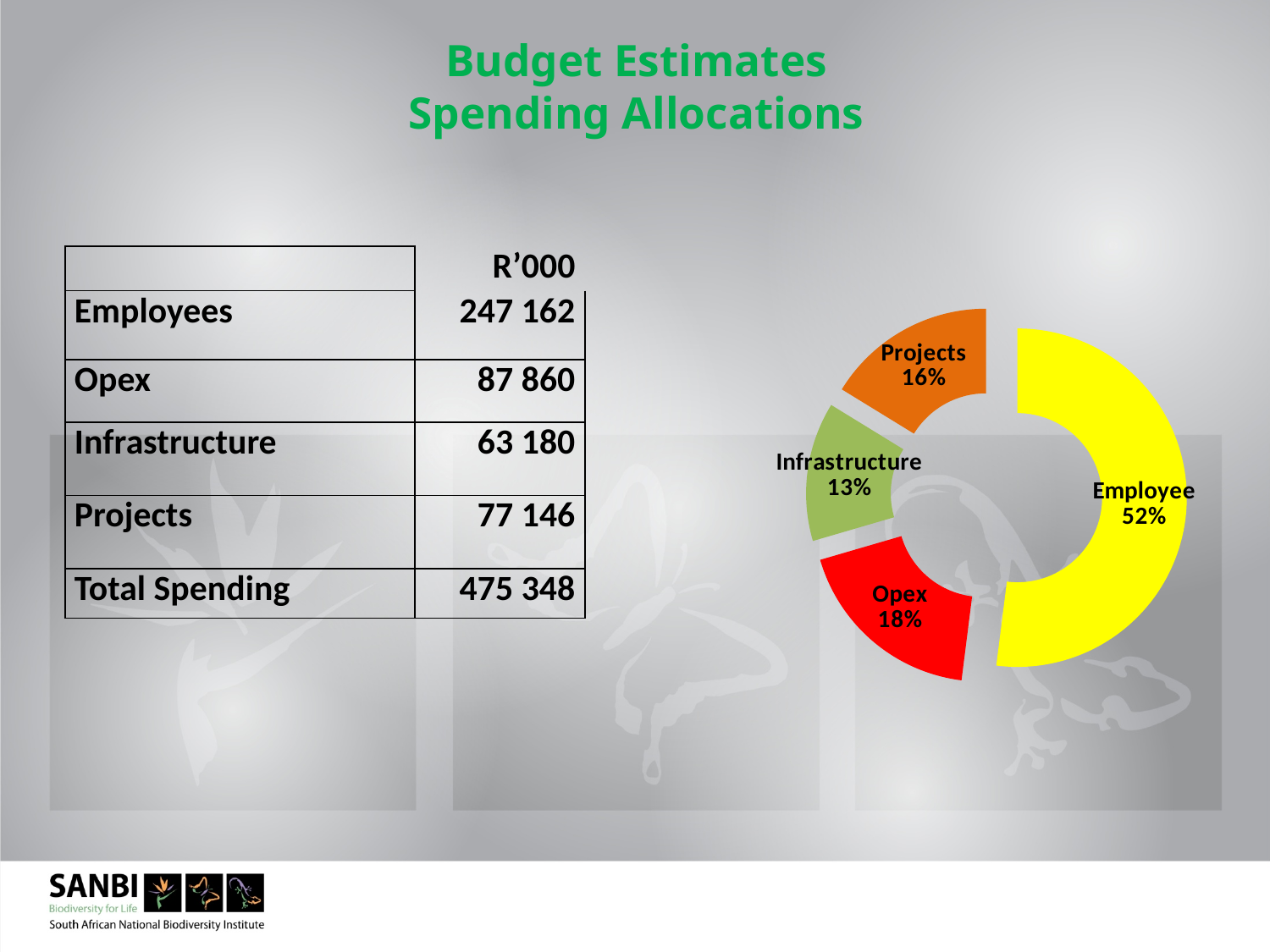
What kind of chart is shown on the slide? Doughnut chart What colour is the Employee slice in the chart? Yellow What share of the doughnut chart does the Employee slice represent? 52% What is the difference in percentage points between the Projects slice and the Infrastructure slice? 3 Which slice of the chart is the largest? Employee What percentage is shown for the Projects slice in the chart? 16% What is the difference in percentage points between the Employee slice and the Opex slice? 34 How many slices does the chart have? 4 Which slice is larger, Opex or Projects? Opex What percentage is shown for the Opex slice in the chart? 18% Which slice of the chart is the smallest? Infrastructure What percentage is shown for the Infrastructure slice in the chart? 13%